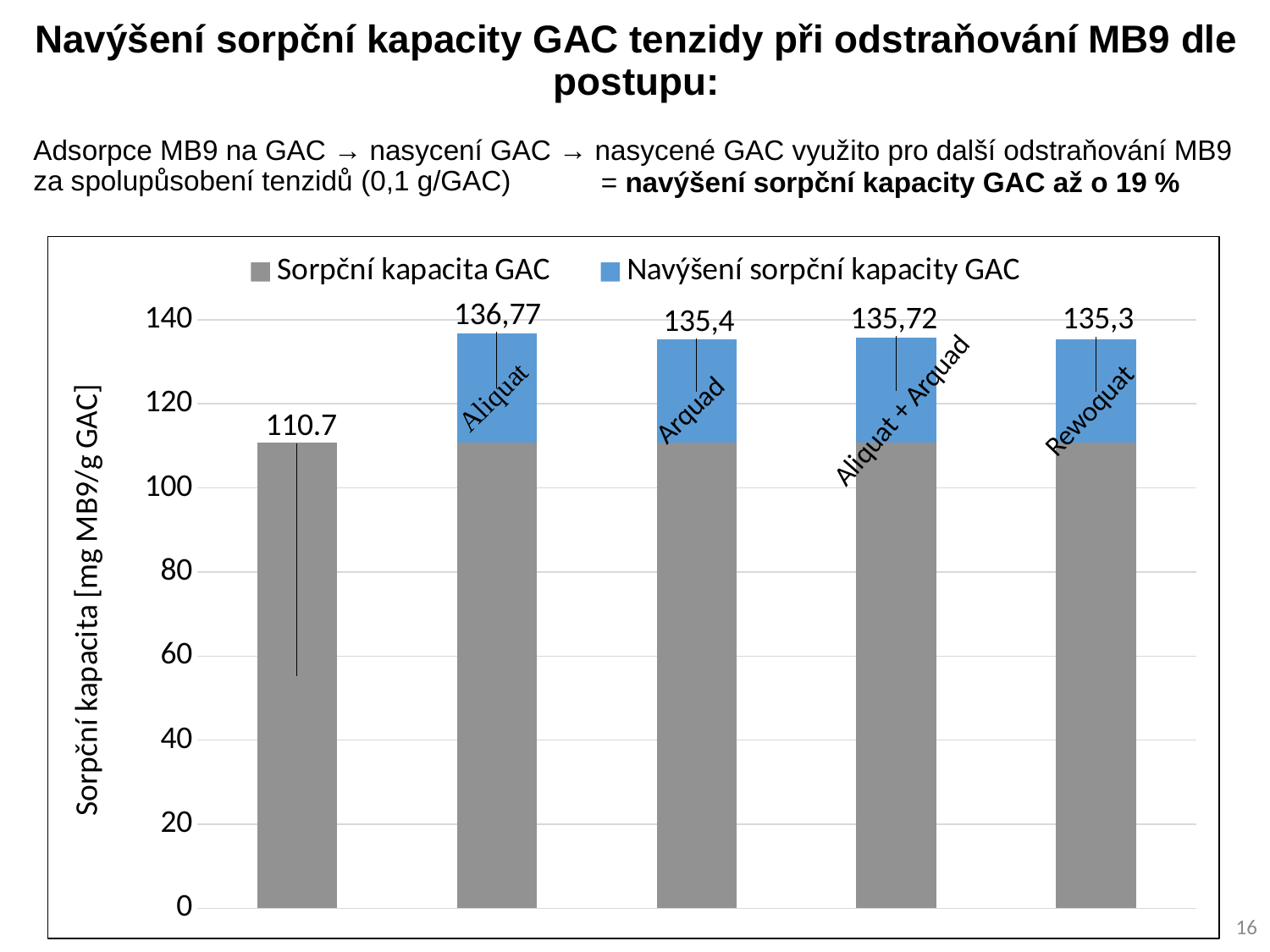
What value is labelled on the first (leftmost) bar, which has no surfactant? 110.7 How many series does the legend list? 2 Which is larger, the total for Aliquat + Arquad or the total for Rewoquat? Aliquat + Arquad What is the total value labelled on the Rewoquat bar? 135,3 What is the total value labelled on the Arquad bar? 135,4 What is the total value labelled on the Aliquat + Arquad bar? 135,72 How many bars are plotted in the chart? 5 Which surfactant bar has the lowest total sorption capacity? Rewoquat Which surfactant bar has the highest total sorption capacity? Aliquat What kind of chart is shown on the slide? Stacked bar chart What is the total value labelled on the Aliquat bar? 136,77 What is the difference between the total for Aliquat and the total for Arquad? 1,37